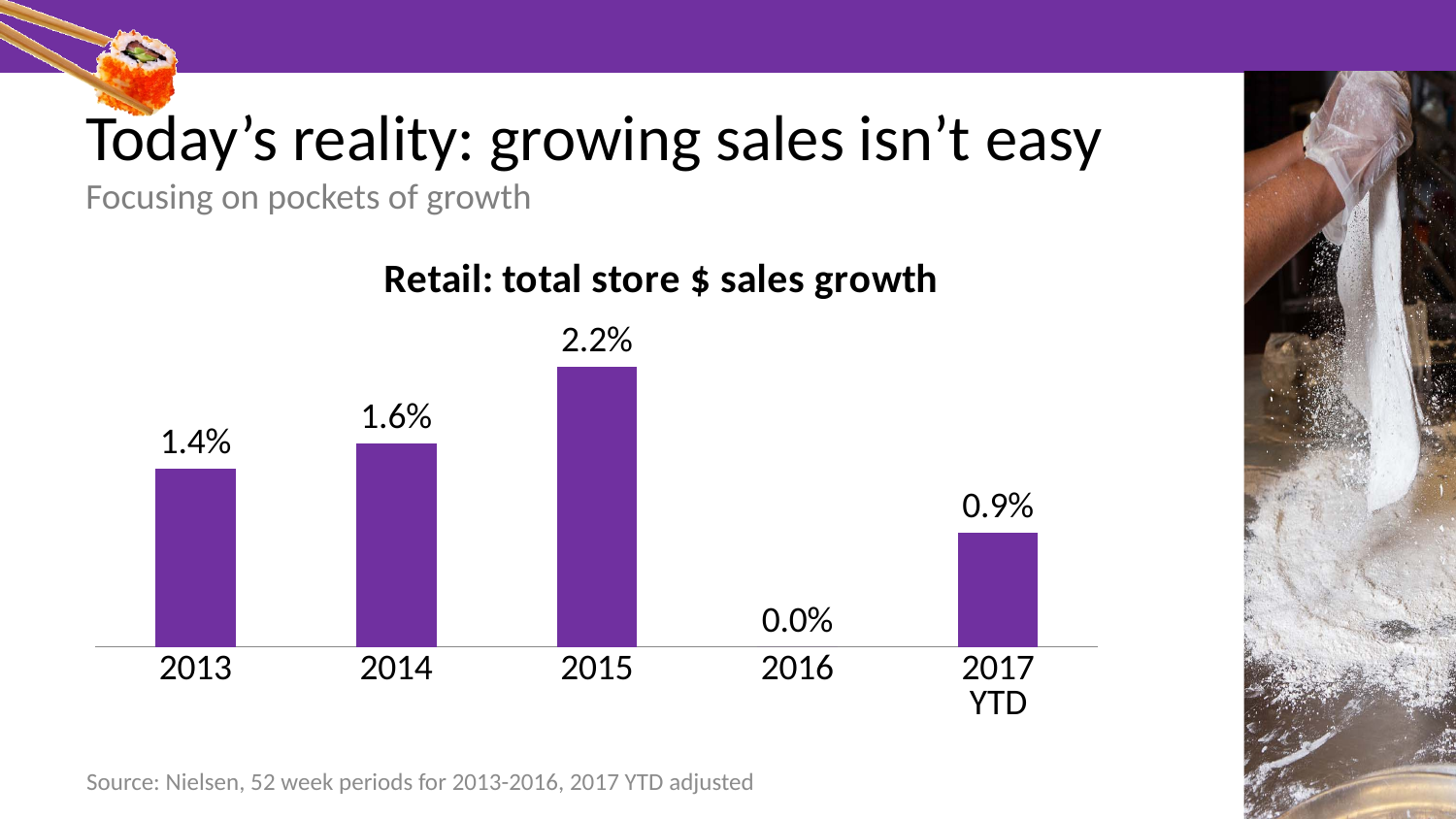
What kind of chart is shown on the slide? Bar chart What is the title of the chart? Retail: total store $ sales growth Does the sales growth rise or fall from 2013 to 2015? Rise How many years are shown on the chart? 5 What is the retail total store $ sales growth for 2017 YTD? 0.9% What is the difference between the sales growth in 2013 and 2017 YTD? 0.5% Which year has the highest retail total store $ sales growth? 2015 What is the retail total store $ sales growth for 2016? 0.0% What is the difference between the sales growth in 2015 and 2014? 0.6% What is the retail total store $ sales growth for 2015? 2.2% Which year has the lowest retail total store $ sales growth? 2016 Which year had higher sales growth, 2013 or 2014? 2014